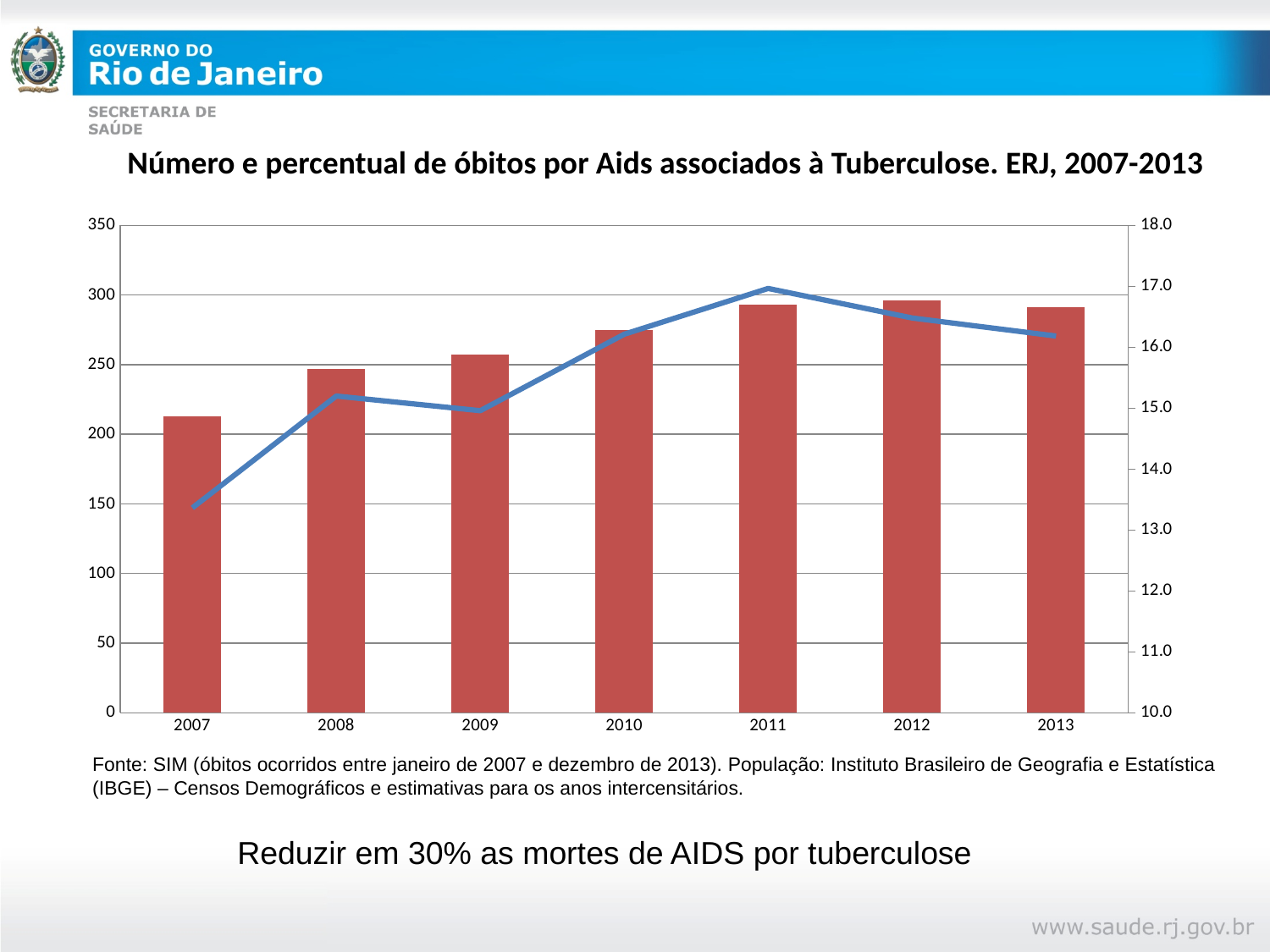
Is the bar for 2011 greater or less than 250? greater Is the line value for 2011 greater or less than 16.0 on the right axis? greater Which bar is taller, 2007 or 2010? 2010 What kind of chart is shown on the slide? A combined bar and line chart Is the line value for 2007 greater or less than 14.0 on the right axis? less Which year has the lowest bar in the chart? 2007 Do the bars rise or fall from 2007 to 2011? rise In which year does the line reach its highest point? 2011 What is the title of the chart? Número e percentual de óbitos por Aids associados à Tuberculose. ERJ, 2007-2013 How many years are shown on the x axis of the chart? 7